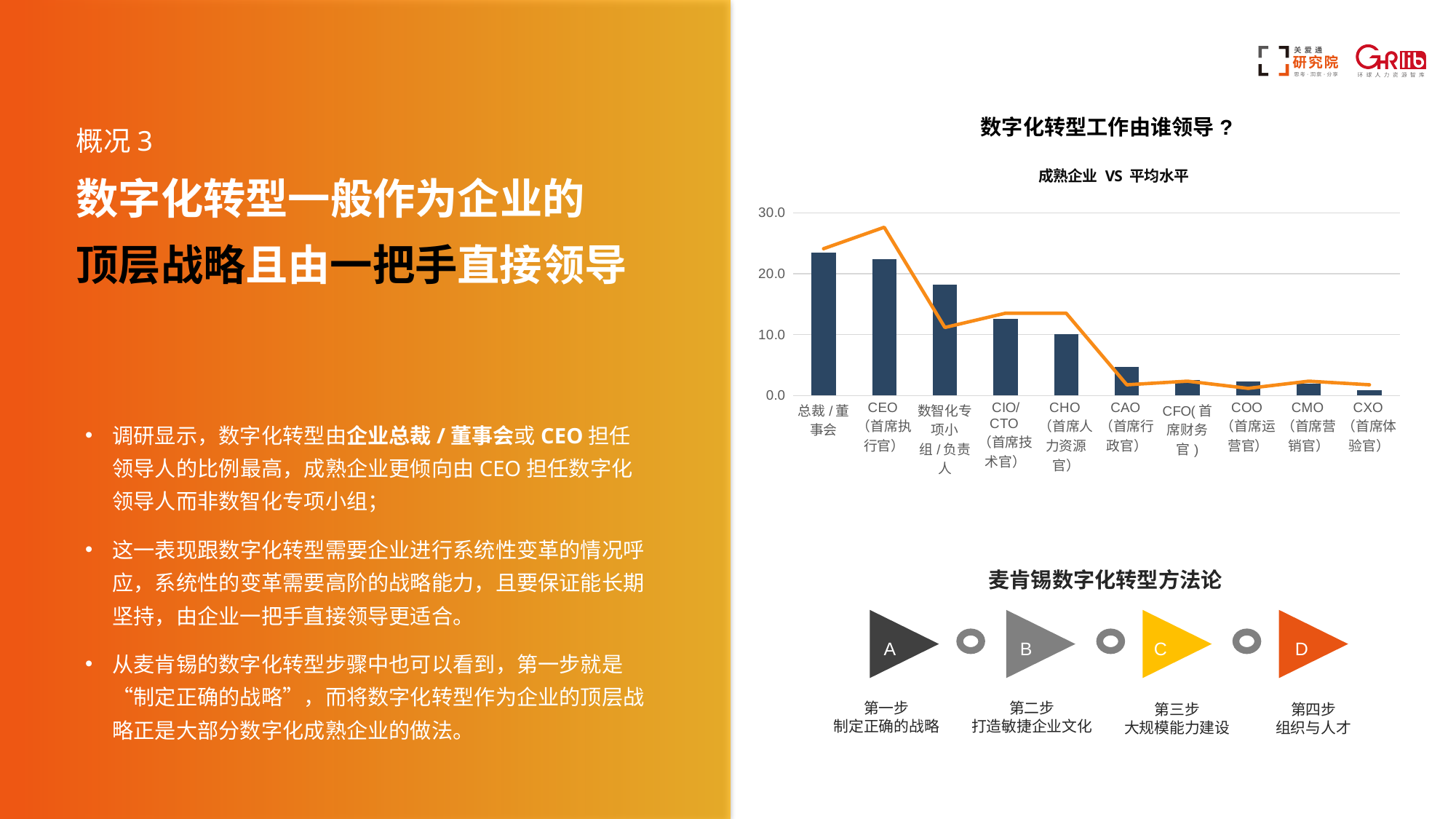
Is the bar value for 总裁/董事会 greater or less than 20.0? greater Do the bar values generally rise or fall from left to right along the x axis? fall What kind of chart is shown under the title 数字化转型工作由谁领导？? A bar chart with a line overlay Is the bar value for CAO（首席行政官） greater or less than 10.0? less Is the line value at CEO greater or less than 20.0? greater What is the subtitle shown below the chart title 数字化转型工作由谁领导？? 成熟企业 VS 平均水平 Which category has the lowest bar in the chart? CXO（首席体验官） How many categories are shown on the x axis of the chart? 10 Which has the taller bar, CEO or CHO（首席人力资源官）? CEO Which has the taller bar, 数智化专项小组/负责人 or CIO/CTO? 数智化专项小组/负责人